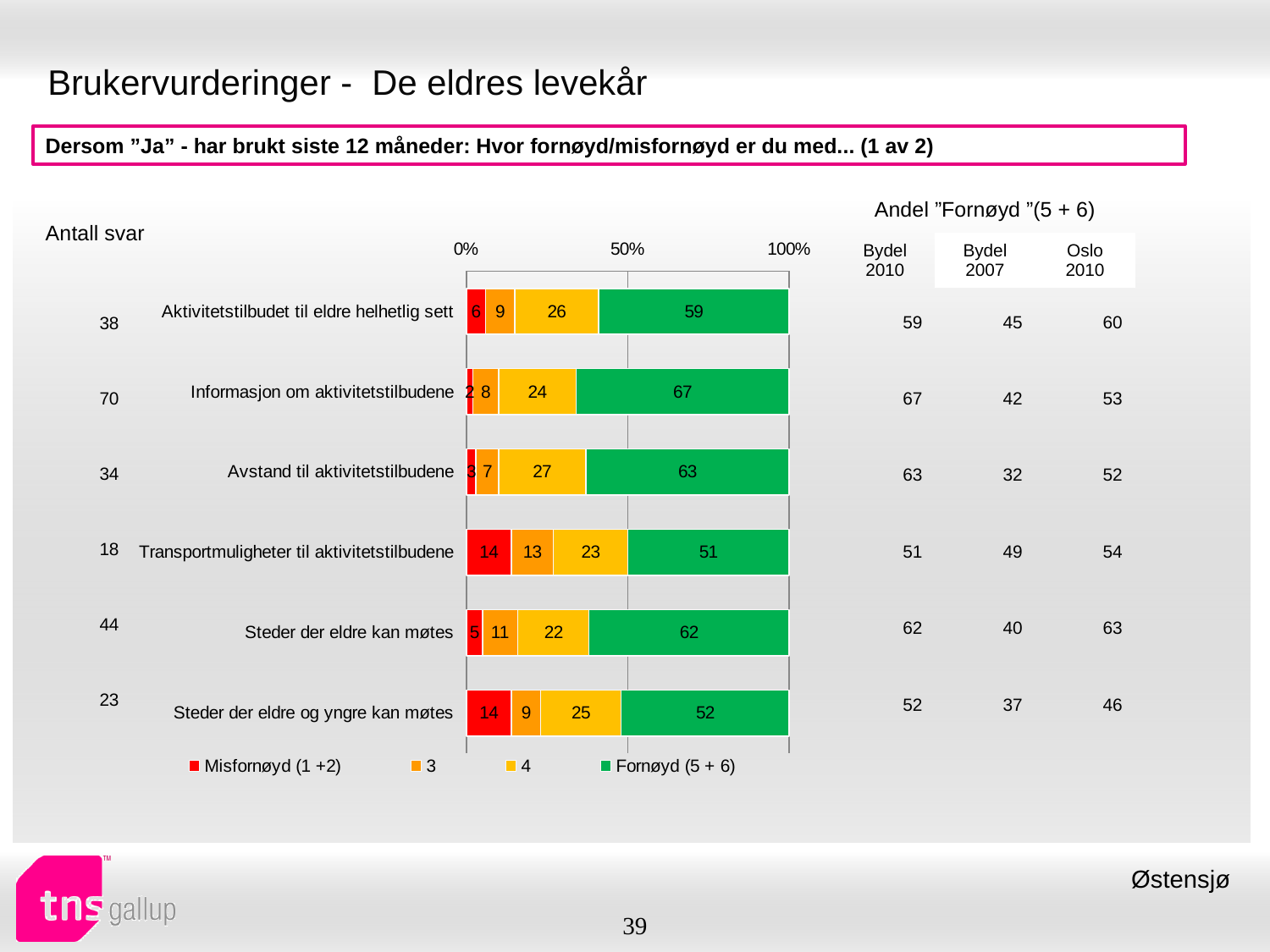
Which category has the highest Fornøyd (5 + 6) value? Informasjon om aktivitetstilbudene What is the value of the Fornøyd (5 + 6) segment for Informasjon om aktivitetstilbudene? 67 What is the value of the '4' segment for Avstand til aktivitetstilbudene? 27 Which has the larger Misfornøyd (1 +2) value: Transportmuligheter til aktivitetstilbudene or Aktivitetstilbudet til eldre helhetlig sett? Transportmuligheter til aktivitetstilbudene Is the Fornøyd (5 + 6) value for Steder der eldre kan møtes greater or less than 50%? greater What is the Misfornøyd (1 +2) value for Transportmuligheter til aktivitetstilbudene? 14 What is the total of the stacked bar for Aktivitetstilbudet til eldre helhetlig sett? 100 How many series does the legend list? 4 What kind of chart is shown on the slide? Stacked bar chart Which category has the lowest Fornøyd (5 + 6) value? Transportmuligheter til aktivitetstilbudene How many categories are shown in the bar chart? 6 What is the difference between the Fornøyd (5 + 6) values for Informasjon om aktivitetstilbudene and Transportmuligheter til aktivitetstilbudene? 16